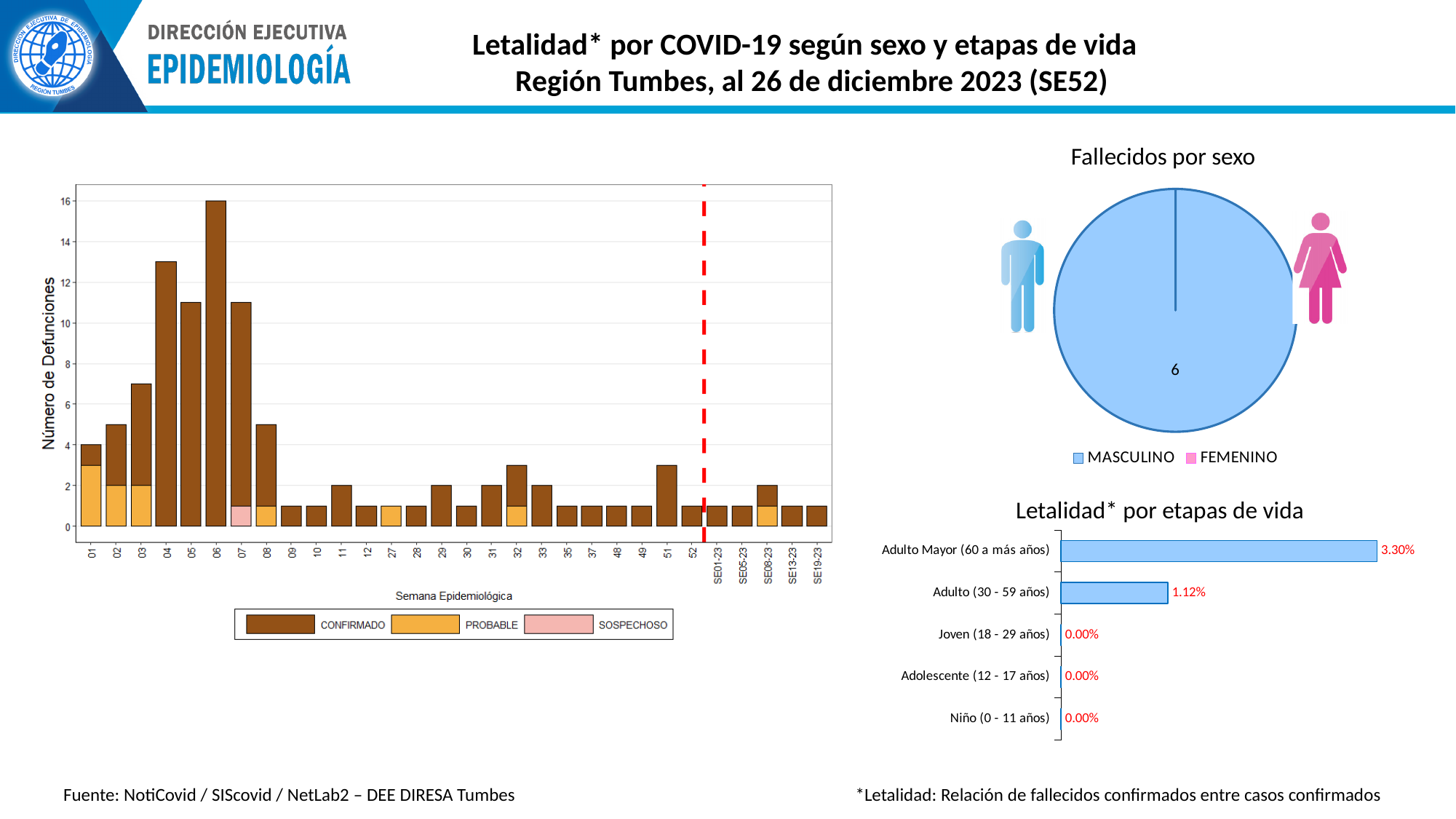
In the 'Letalidad* por etapas de vida' chart, how many age groups are shown? 5 In the 'Fallecidos por sexo' pie chart, what is the value shown for MASCULINO? 6 In the bar chart on the left (Número de Defunciones by Semana Epidemiológica), is the value for week 04 greater or less than 12? greater In the 'Letalidad* por etapas de vida' chart, which age group has the highest value? Adulto Mayor (60 a más años) In the 'Fallecidos por sexo' pie chart, how many entries does the legend list? 2 In the bar chart on the left (Número de Defunciones by Semana Epidemiológica), how many series does the legend list? 3 In the 'Letalidad* por etapas de vida' chart, how many age groups have a value of 0.00%? 3 In the 'Letalidad* por etapas de vida' chart, what is the difference between the values for Adulto Mayor (60 a más años) and Adulto (30 - 59 años)? 2.18% In the 'Letalidad* por etapas de vida' chart, what is the value for Adulto Mayor (60 a más años)? 3.30% In the bar chart on the left (Número de Defunciones by Semana Epidemiológica), which week has the highest number of deaths? 06 In the 'Letalidad* por etapas de vida' chart, what is the value for Adulto (30 - 59 años)? 1.12% In the bar chart on the left (Número de Defunciones by Semana Epidemiológica), what is the total number of deaths in week 06? 16